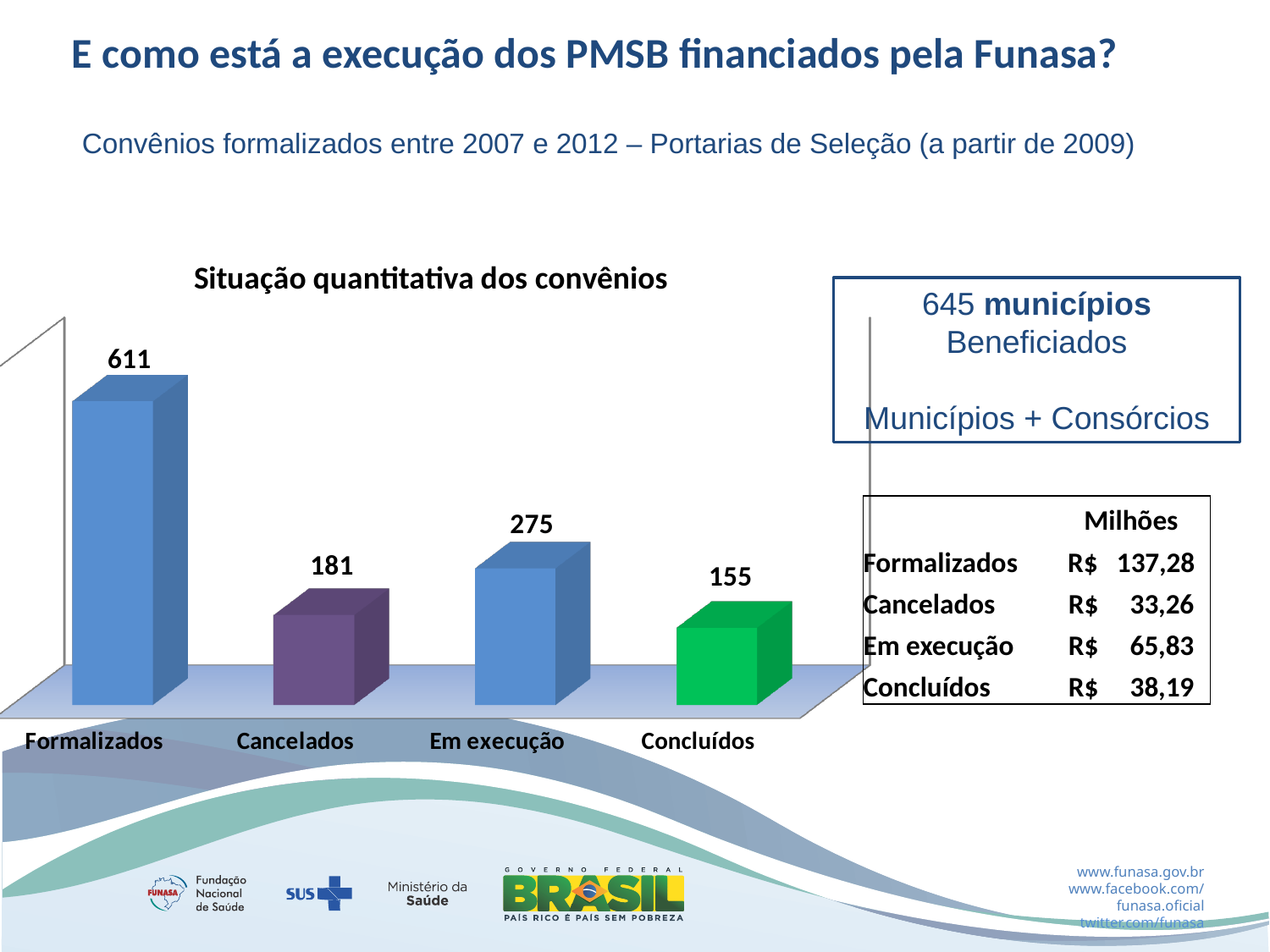
What is the value for Formalizados in the chart 'Situação quantitativa dos convênios'? 611 Which category has the highest value in the chart? Formalizados What is the title of the chart on the slide? Situação quantitativa dos convênios What is the difference between the values for Formalizados and Em execução? 336 Which category has the lowest value in the chart? Concluídos What is the value for Concluídos in the chart? 155 What is the value for Cancelados in the chart? 181 What is the value for Em execução in the chart? 275 What is the difference between the values for Cancelados and Concluídos? 26 How many categories are shown in the chart? 4 What kind of chart is shown on the slide? Bar chart Which is larger, the value for Em execução or the value for Cancelados? Em execução